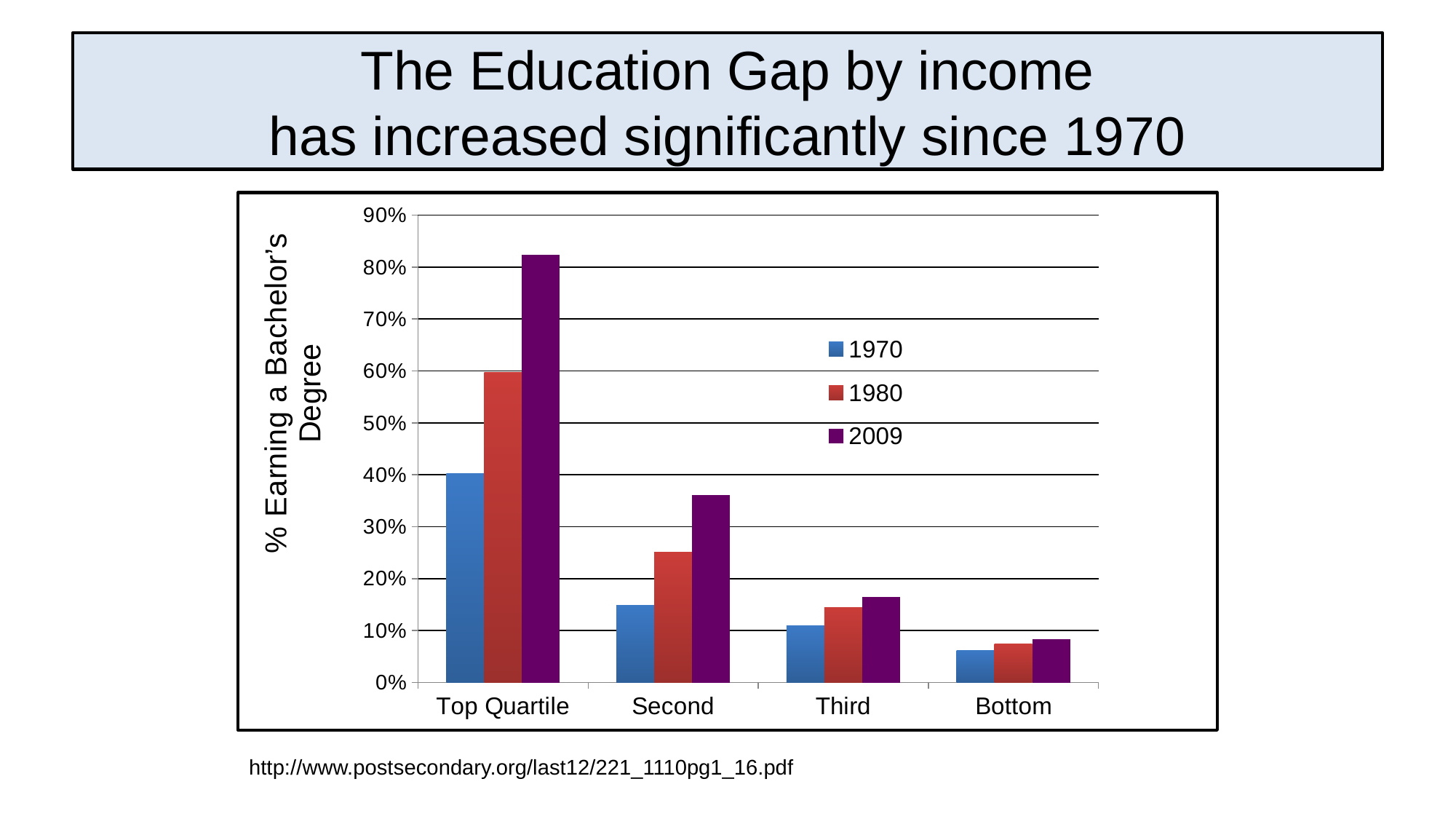
Which is larger for the Third category: the 1970 value or the 2009 value? 2009 How many series does the legend list? 3 Which category has the highest value for the 2009 series? Top Quartile How many income categories are shown on the x axis? 4 Is the 1980 value for Second greater or less than 20%? greater Is the 1970 value for Bottom greater or less than 10%? less What kind of chart is shown on the slide? bar chart What is the label on the vertical axis of the chart? % Earning a Bachelor's Degree Is the 2009 value for Top Quartile greater or less than 80%? greater Which category has the lowest value for the 1970 series? Bottom Do the 2009 values rise or fall moving from Top Quartile to Bottom along the x axis? fall